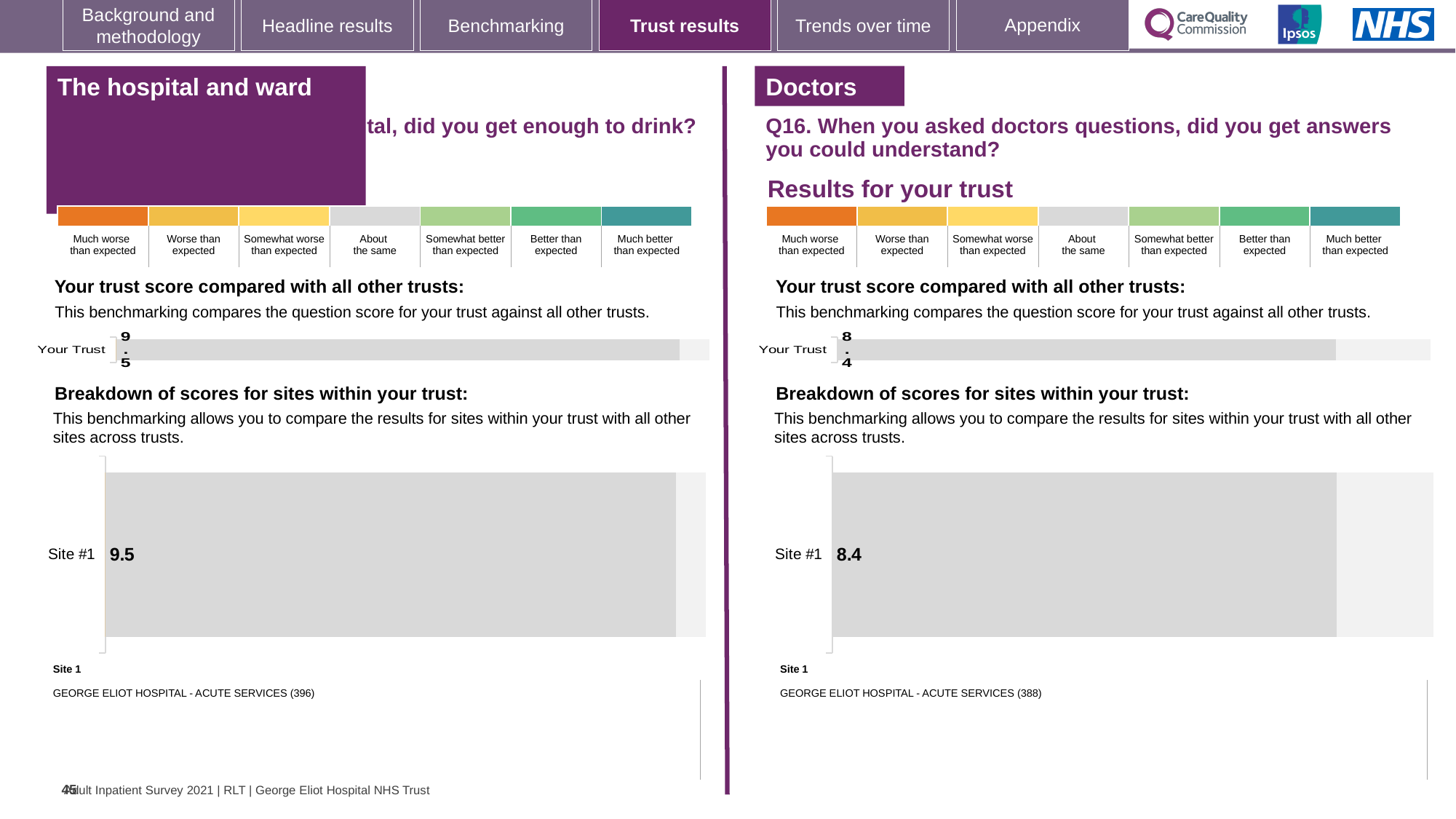
In the left panel (The hospital and ward), what is the score shown for Your Trust? 9.5 How many sites are shown in the breakdown of scores chart in the right panel (Doctors, Q16)? 1 In the left panel (The hospital and ward), what score is shown for Site #1 in the breakdown of scores for sites? 9.5 In the right panel (Doctors, Q16), what score is shown for Site #1 in the breakdown of scores for sites? 8.4 Which panel shows the higher Your Trust score: the left panel (The hospital and ward) or the right panel (Doctors, Q16)? The left panel (The hospital and ward) How many categories does the colour scale above the charts list, from 'Much worse than expected' to 'Much better than expected'? 7 Which panel shows the higher Site #1 score: the left panel (The hospital and ward) or the right panel (Doctors, Q16)? The left panel (The hospital and ward) In the right panel (Doctors, Q16), which site is listed as Site 1 below the breakdown chart? GEORGE ELIOT HOSPITAL - ACUTE SERVICES (388) What is the difference between the Site #1 score in the left panel (9.5) and the Site #1 score in the right panel (8.4)? 1.1 How many sites are shown in the breakdown of scores chart in the left panel (The hospital and ward)? 1 What kind of chart is used to show the Site #1 score in the right panel (Doctors, Q16)? Bar chart In the right panel (Doctors, Q16), what is the score shown for Your Trust? 8.4